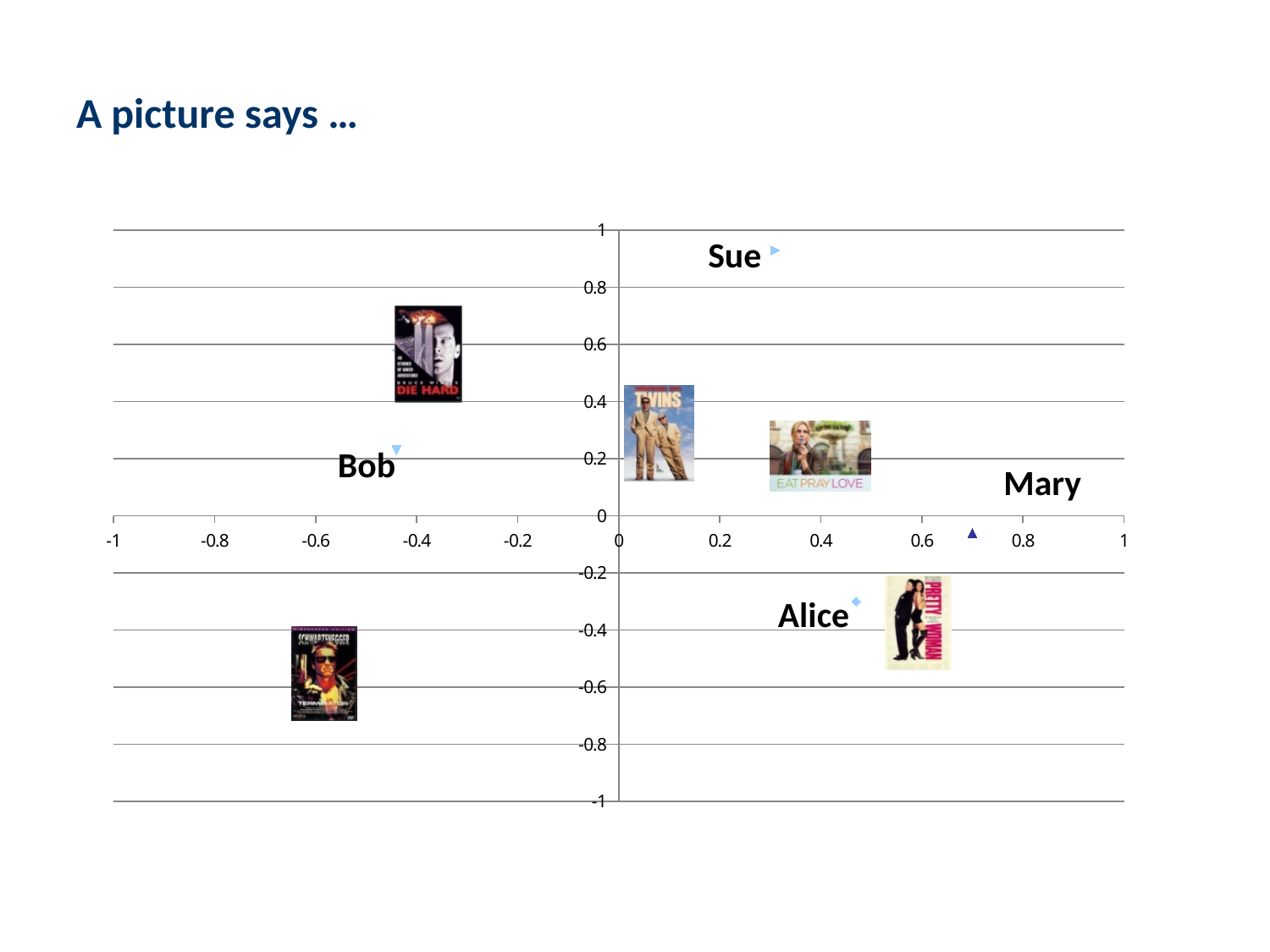
Which labeled point has the largest horizontal (x) value? Mary Is the horizontal (x) value for Bob greater or less than -0.2? less Which labeled point has the highest vertical (y) value? Sue Is the vertical (y) value for Sue greater or less than 0.8? greater What is the title of the slide containing the chart? A picture says … How many labeled data points (people) are plotted on the chart? 4 What kind of chart is shown on the slide? scatter chart Which labeled point has the smallest horizontal (x) value? Bob Which point is plotted higher on the vertical axis, Sue or Bob? Sue Is the vertical (y) value for Alice greater or less than -0.2? less Which labeled point has the lowest vertical (y) value? Alice